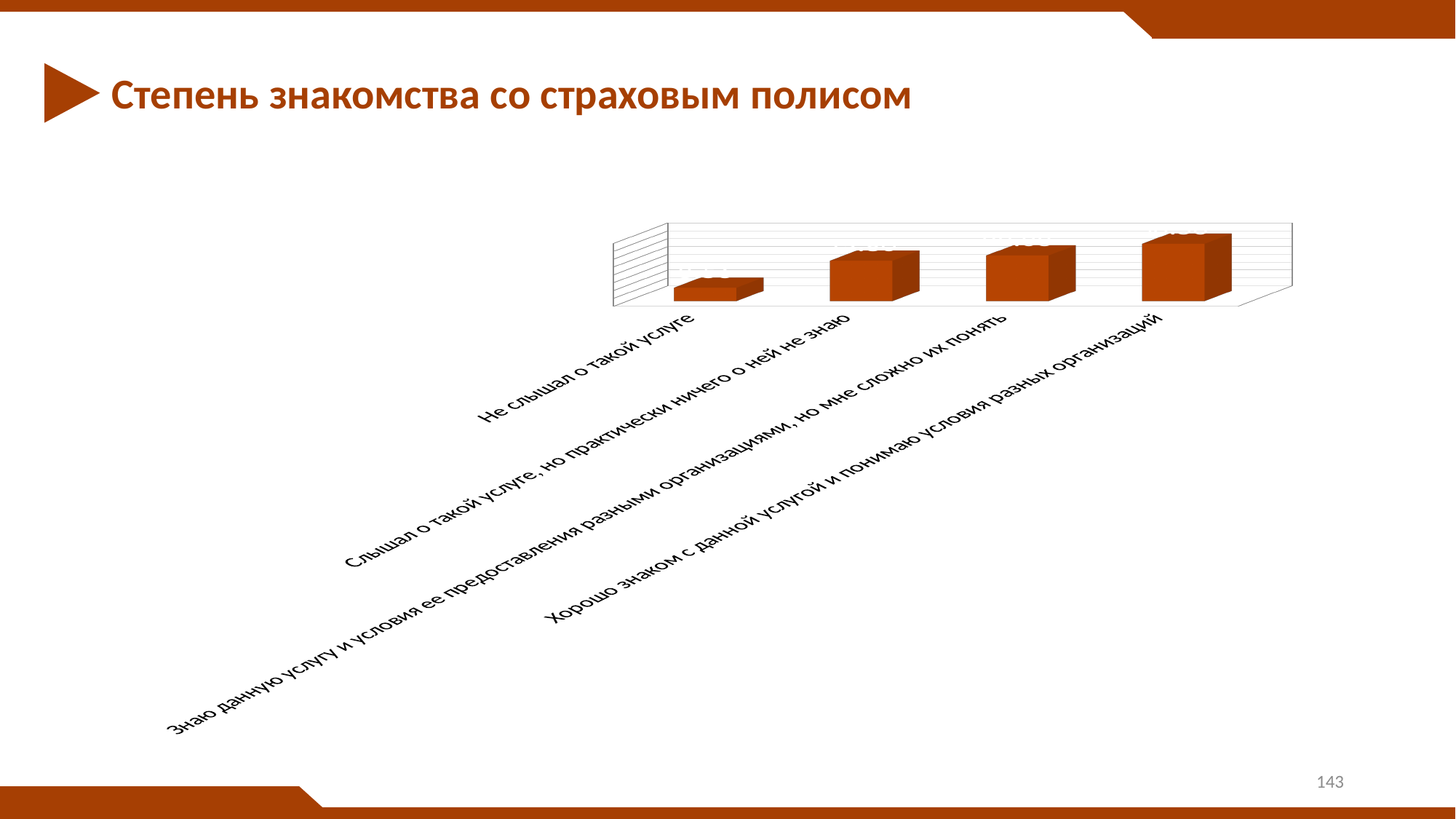
Which category has the lowest bar? Не слышал о такой услуге What is the label of the first (leftmost) category on the x axis? Не слышал о такой услуге What kind of chart is shown on the slide? bar chart Which bar is taller: "Не слышал о такой услуге" or "Слышал о такой услуге, но практически ничего о ней не знаю"? Слышал о такой услуге, но практически ничего о ней не знаю How many categories are shown in the chart? 4 Which bar is taller: "Хорошо знаком с данной услугой и понимаю условия разных организаций" or "Не слышал о такой услуге"? Хорошо знаком с данной услугой и понимаю условия разных организаций Which category has the highest bar? Хорошо знаком с данной услугой и понимаю условия разных организаций Do the bar values rise or fall from left to right along the x axis? rise Which bar is taller: "Слышал о такой услуге, но практически ничего о ней не знаю" or "Хорошо знаком с данной услугой и понимаю условия разных организаций"? Хорошо знаком с данной услугой и понимаю условия разных организаций What colour are the bars in the chart? orange-brown What is the title of the slide containing the chart? Степень знакомства со страховым полисом